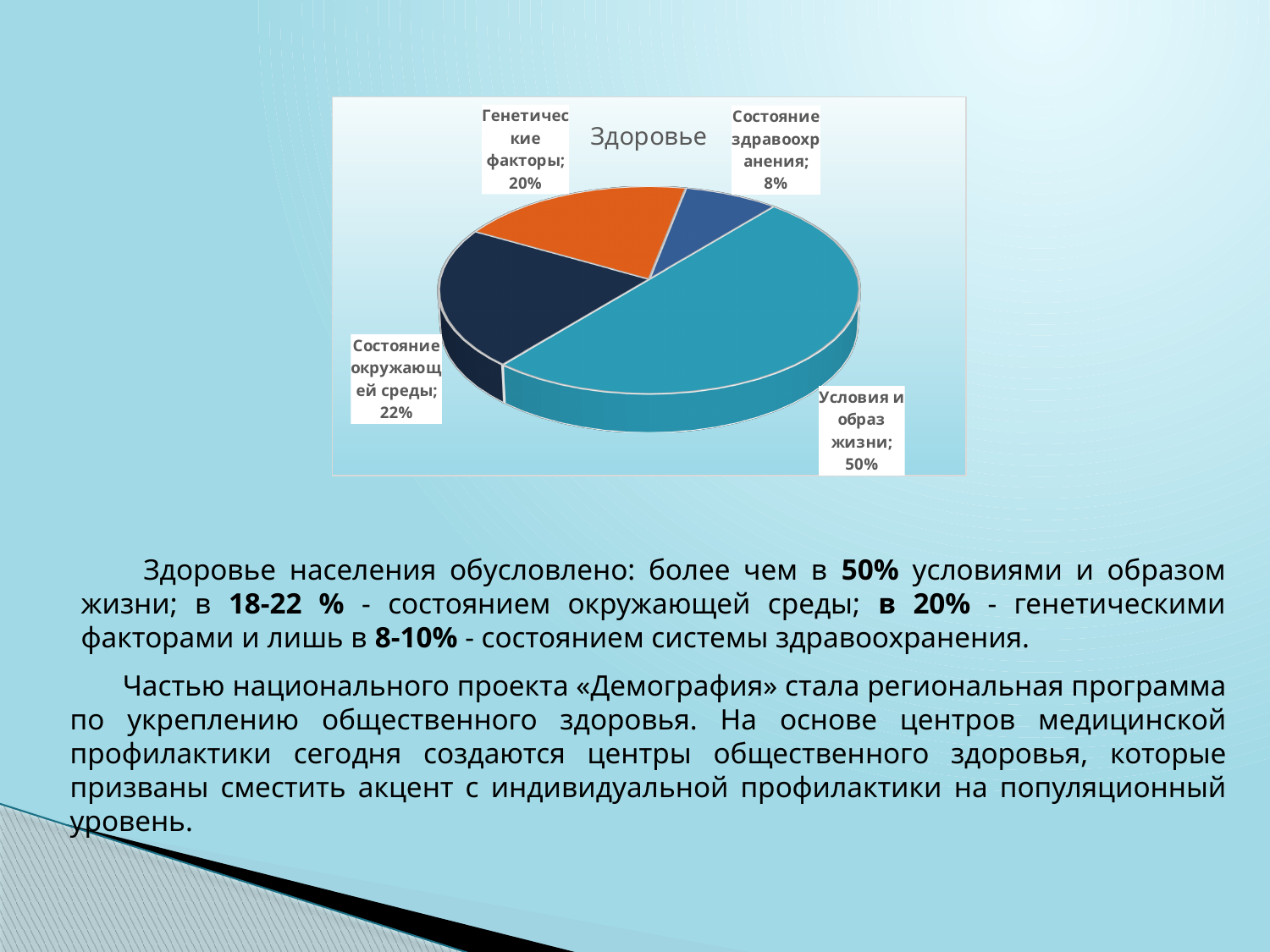
What is the difference in percentage points between "Генетические факторы" and "Состояние здравоохранения"? 12 What is the difference in percentage points between "Условия и образ жизни" and "Состояние окружающей среды"? 28 What percentage is shown for "Генетические факторы"? 20% What percentage is shown for "Состояние окружающей среды"? 22% What is the title of the chart? Здоровье Which is larger: the slice for "Состояние окружающей среды" or the slice for "Генетические факторы"? Состояние окружающей среды Which category has the smallest slice of the pie? Состояние здравоохранения What type of chart is shown on the slide? Pie chart Which category has the largest slice of the pie? Условия и образ жизни What percentage is shown for "Состояние здравоохранения"? 8% How many slices does the pie chart have? 4 What share of the pie does "Условия и образ жизни" represent? 50%